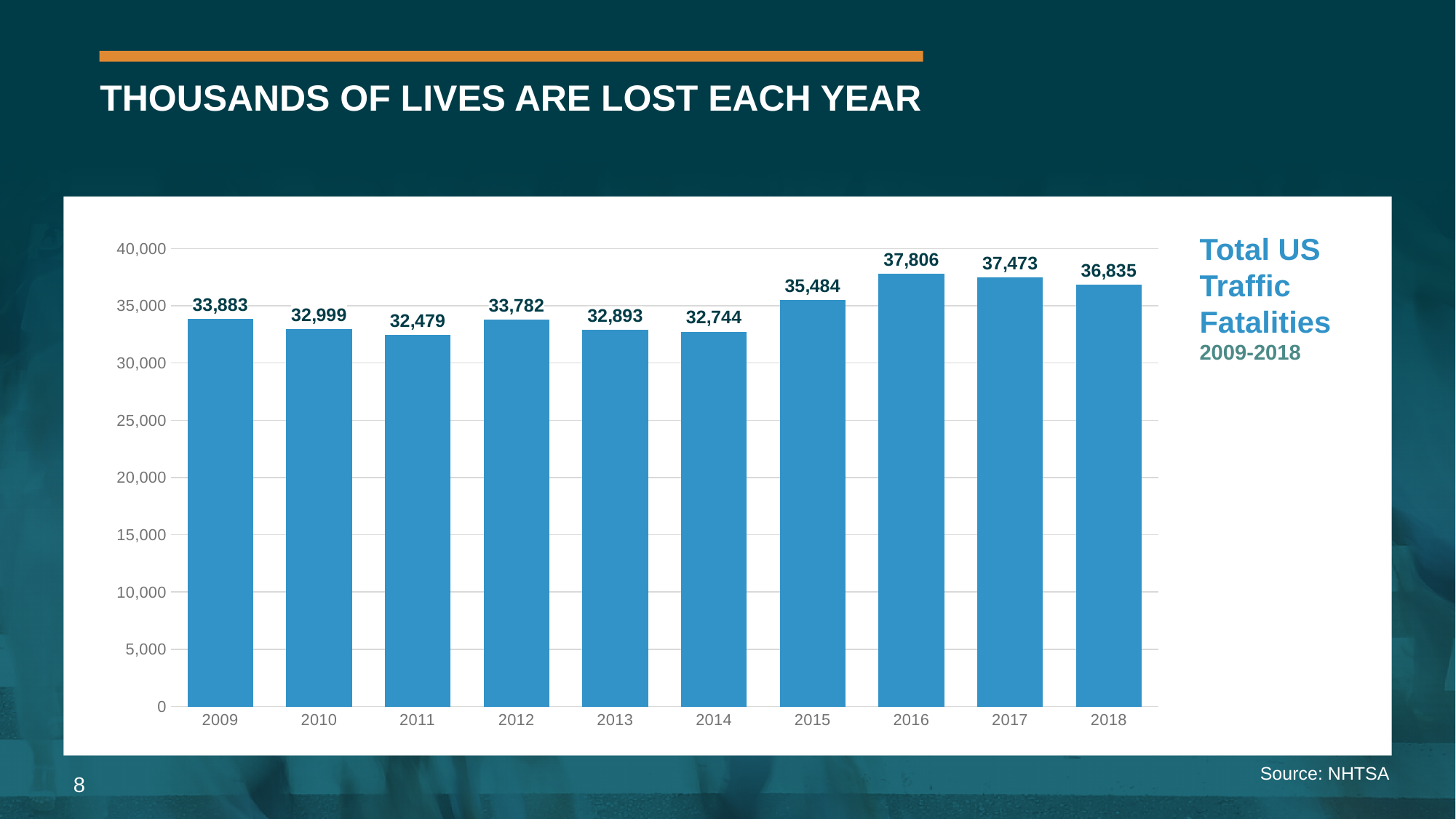
How many years are shown on the chart? 10 What kind of chart is shown on the slide? Bar chart What was the total number of US traffic fatalities in 2011? 32,479 Which year had more traffic fatalities, 2017 or 2018? 2017 Which year had the lowest number of US traffic fatalities? 2011 What is the difference in traffic fatalities between 2016 and 2015? 2,322 What is the difference in traffic fatalities between 2009 and 2014? 1,139 What is the source cited for the chart data? NHTSA Is the value for 2015 greater or less than 35,000? greater Which year had the highest number of US traffic fatalities? 2016 What was the total number of US traffic fatalities in 2018? 36,835 What was the total number of US traffic fatalities in 2016? 37,806